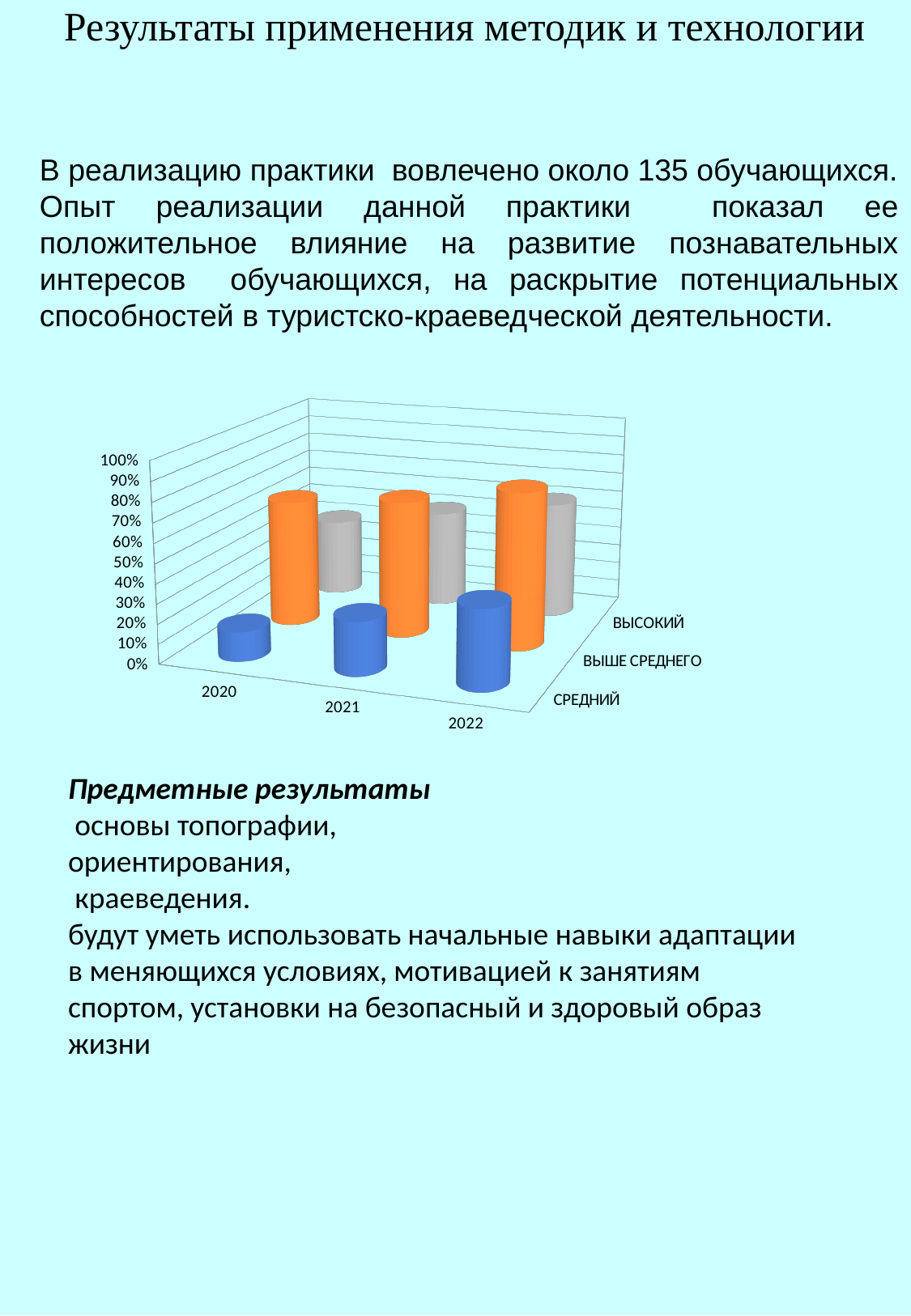
Do the values for ВЫШЕ СРЕДНЕГО rise or fall from 2020 to 2022? rise How many series (levels) does the chart show? 3 Which series has the lowest values in every year? СРЕДНИЙ Do the values for СРЕДНИЙ rise or fall from 2020 to 2022? rise What colour are the bars for the СРЕДНИЙ series? blue Which series has the highest values in every year? ВЫШЕ СРЕДНЕГО How many years are shown along the x axis of the chart? 3 Is the value for СРЕДНИЙ in 2020 greater or less than 50%? less Is the value for ВЫШЕ СРЕДНЕГО in 2020 greater or less than 50%? greater In 2022, which is larger: ВЫСОКИЙ or СРЕДНИЙ? ВЫСОКИЙ Is the value for СРЕДНИЙ in 2022 greater or less than 50%? less What kind of chart is shown on the slide? bar chart